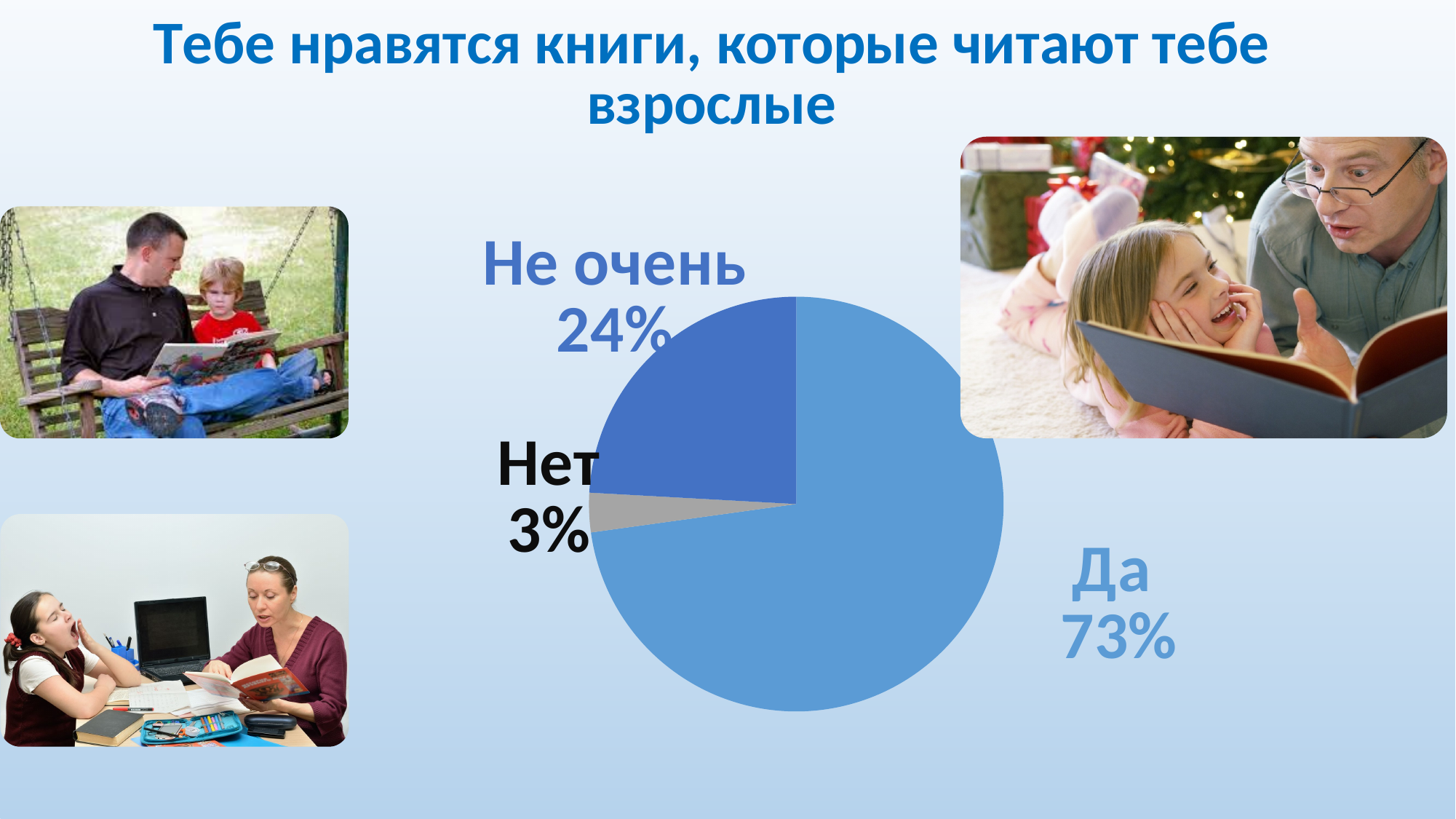
Which answer has the largest share of the pie? Да What percentage of respondents answered "Нет"? 3% What percentage of respondents answered "Не очень"? 24% What is the difference in percentage points between "Да" and "Не очень"? 49 Which is larger, the share for "Не очень" or the share for "Нет"? Не очень What is the difference in percentage points between "Не очень" and "Нет"? 21 How many slices does the pie chart have? 3 Which answer has the smallest share of the pie? Нет What colour is the "Нет" slice of the pie? Grey What percentage of respondents answered "Да"? 73% What kind of chart is shown on the slide? Pie chart What is the title of the slide containing the chart? Тебе нравятся книги, которые читают тебе взрослые